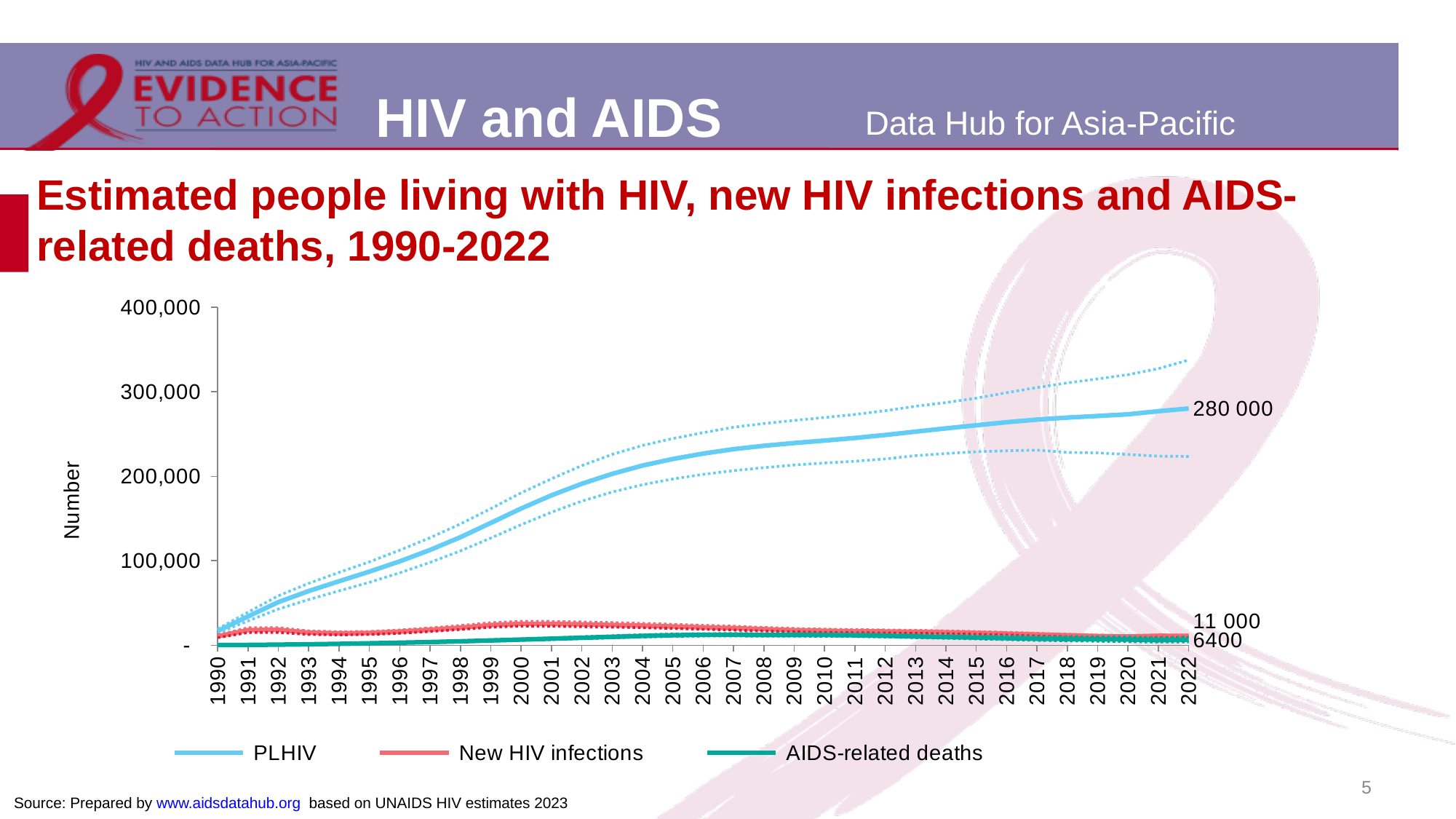
What is the value for PLHIV in 2022? 280 000 What is the value for New HIV infections in 2022? 11 000 What is the difference between New HIV infections and AIDS-related deaths in 2022? 4600 Is the value for PLHIV in 1993 greater or less than 100,000? less Which series has the highest value in 2022? PLHIV Which series has the lowest value in 2022? AIDS-related deaths Is the value for PLHIV in 2010 greater or less than 200,000? greater How many series does the legend list? 3 Does the PLHIV line rise or fall from 1990 to 2022? Rises What is the value for AIDS-related deaths in 2022? 6400 In 2022, which is larger: PLHIV or New HIV infections? PLHIV What kind of chart is shown on the slide? Line chart